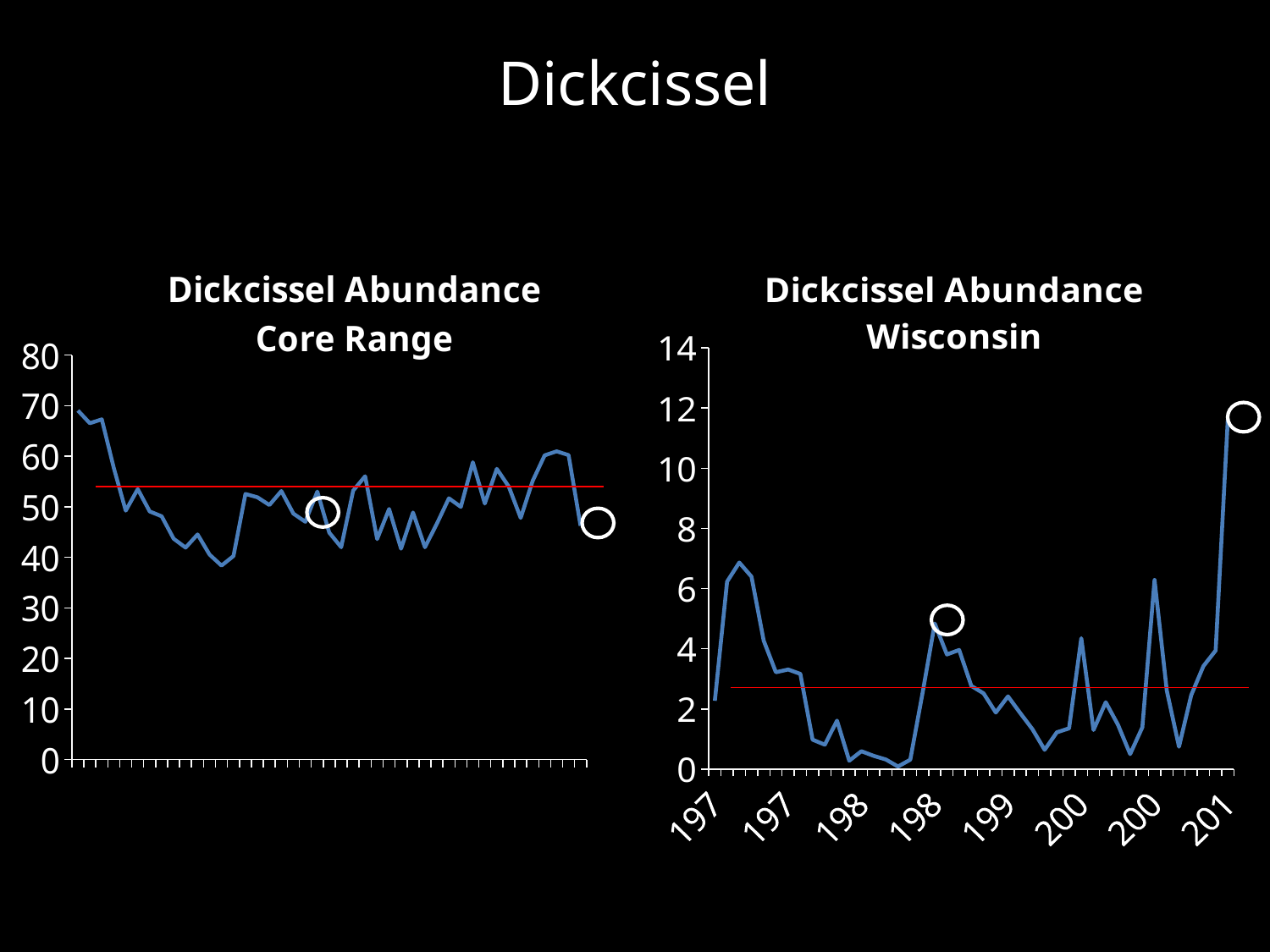
In the 'Dickcissel Abundance Wisconsin' chart, is the value of the first point on the line greater or less than 4? less What is the title of the chart on the right side of the slide? Dickcissel Abundance Wisconsin In the 'Dickcissel Abundance Core Range' chart, is the highest point on the line at the beginning or at the end of the series? at the beginning What kind of chart is the 'Dickcissel Abundance Wisconsin' chart? line chart In the 'Dickcissel Abundance Core Range' chart, is the lowest point on the line greater or less than 40? less In the 'Dickcissel Abundance Wisconsin' chart, is the value of the last point on the line greater or less than 10? greater What is the highest value shown on the y axis of the 'Dickcissel Abundance Wisconsin' chart? 14 What kind of chart is the 'Dickcissel Abundance Core Range' chart? line chart In the 'Dickcissel Abundance Wisconsin' chart, is the highest point on the line at the beginning or at the end of the series? at the end How many charts are shown on the slide? 2